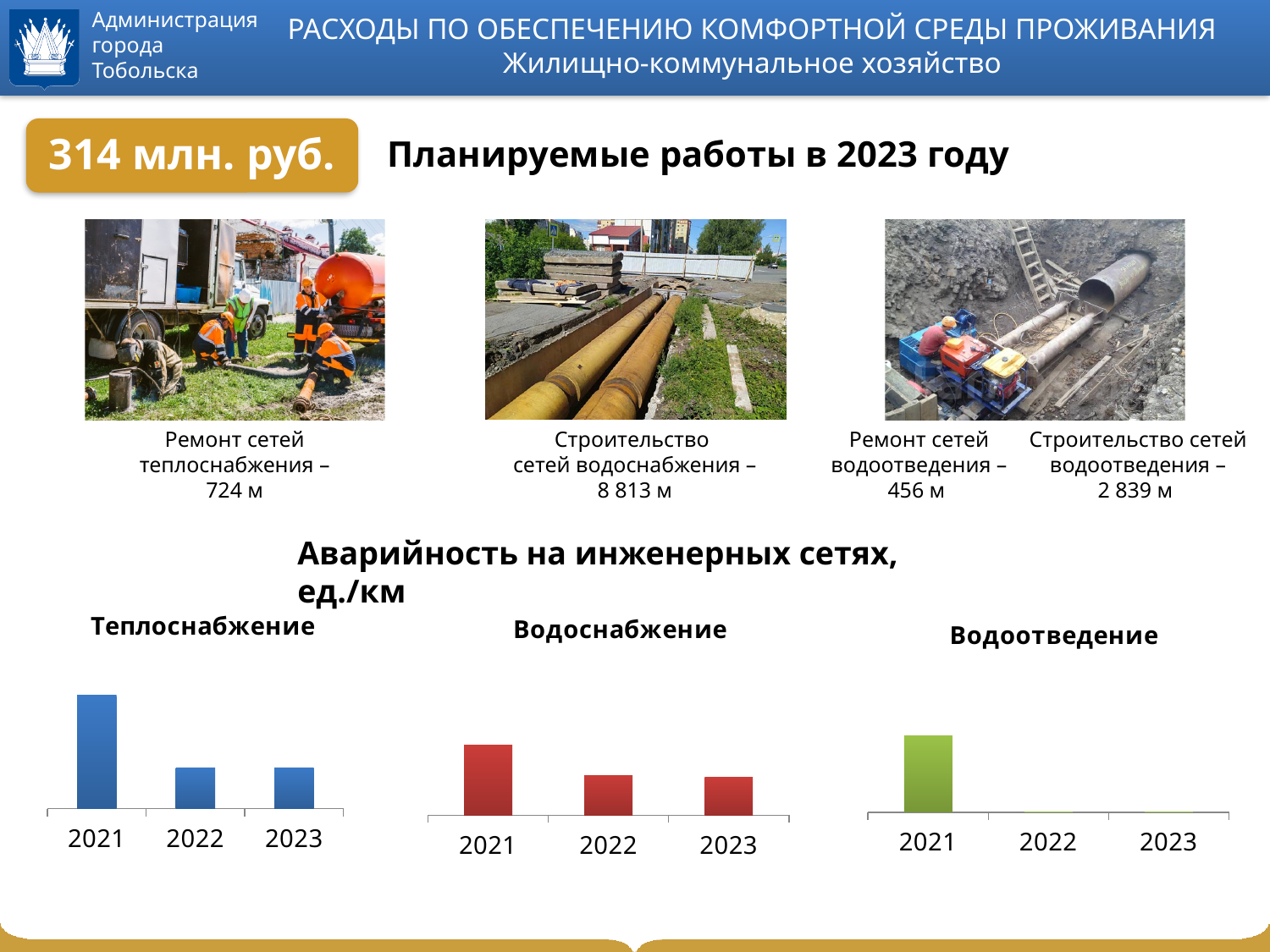
How many years are shown on the x axis of the Теплоснабжение chart? 3 Do the values in the Водоснабжение chart rise or fall from 2021 to 2022? fall In the Водоотведение chart, which is larger, the value for 2021 or the value for 2022? 2021 What colour are the bars in the Водоснабжение chart? red In the Водоснабжение chart, which year has the highest value? 2021 In the Теплоснабжение chart, which is larger, the value for 2021 or the value for 2022? 2021 How many bar charts are shown under the heading 'Аварийность на инженерных сетях, ед./км'? 3 What colour are the bars in the Водоотведение chart? green In the Теплоснабжение chart, which year has the highest value? 2021 What kind of chart is the Теплоснабжение chart? bar chart In the Водоотведение chart, which year has the highest value? 2021 In the Водоснабжение chart, which is larger, the value for 2021 or the value for 2023? 2021